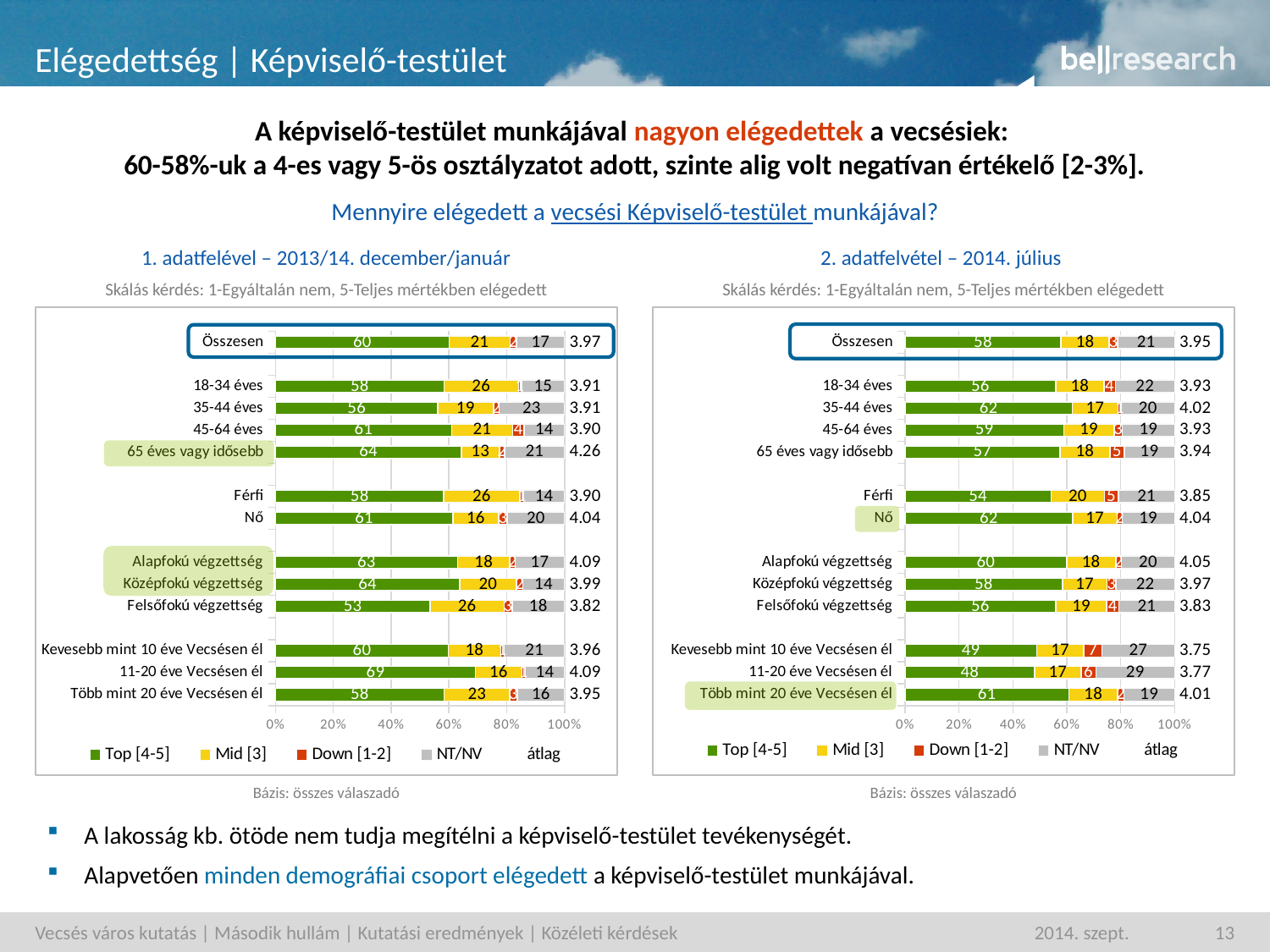
In the right chart (2. adatfelvétel – 2014. július), what is the difference between the Top [4-5] values for Nő and Férfi? 8 How many categories are plotted in the right chart (2. adatfelvétel – 2014. július)? 13 In the left chart (1. adatfelével – 2013/14. december/január), what is the Top [4-5] value for Összesen? 60 In the right chart (2. adatfelvétel – 2014. július), what colour represents the Down [1-2] series? Red In the left chart (1. adatfelével – 2013/14. december/január), which category has the highest Top [4-5] value? 11-20 éve Vecsésen él What type of chart is the left chart (1. adatfelével – 2013/14. december/január)? Stacked bar chart In the right chart (2. adatfelvétel – 2014. július), which category has the lowest Top [4-5] value? 11-20 éve Vecsésen él How many coloured series does the legend of the left chart (1. adatfelével – 2013/14. december/január) list? 4 In the right chart (2. adatfelvétel – 2014. július), what is the átlag value for Összesen? 3.95 In the left chart (1. adatfelével – 2013/14. december/január), which category has the highest átlag value? 65 éves vagy idősebb In the left chart (1. adatfelével – 2013/14. december/január), which has a higher Mid [3] value: Felsőfokú végzettség or 65 éves vagy idősebb? Felsőfokú végzettség In the right chart (2. adatfelvétel – 2014. július), what is the NT/NV value for 11-20 éve Vecsésen él? 29